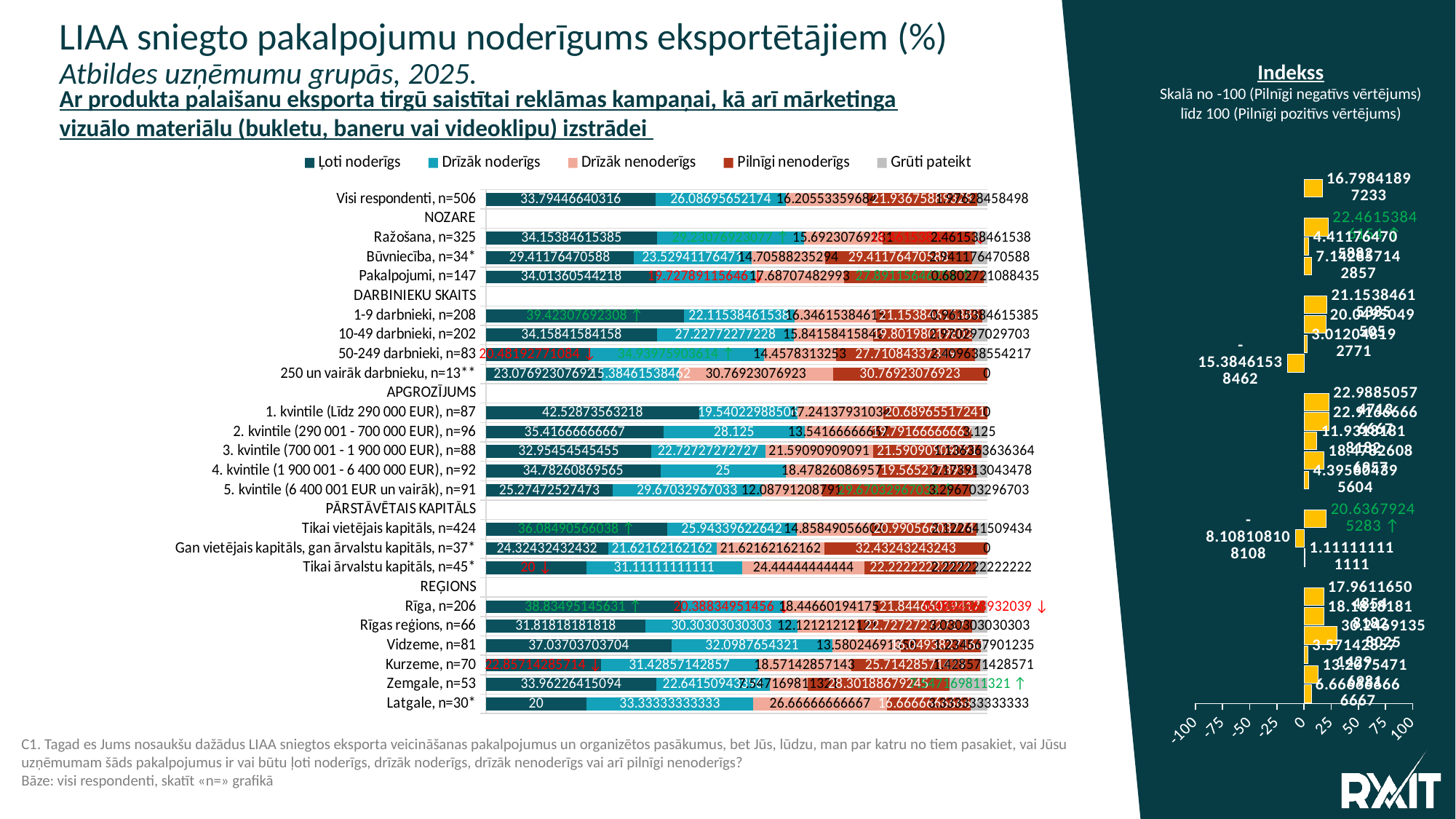
In the main chart, what is the 'Drīzāk noderīgs' value for 'Vidzeme, n=81'? 32.0987654321 In the main chart, which category has the highest 'Ļoti noderīgs' value? 1. kvintile (Līdz 290 000 EUR), n=87 How many series does the legend of the main chart list? 5 In the main chart, what is the 'Ļoti noderīgs' value for 'Tikai ārvalstu kapitāls, n=45*'? 20 In the main chart, what is the 'Ļoti noderīgs' value for '1. kvintile (Līdz 290 000 EUR), n=87'? 42.52873563218 In the main chart, what is the 'Pilnīgi nenoderīgs' value for 'Gan vietējais kapitāls, gan ārvalstu kapitāls, n=37*'? 32.43243243243 In the 'Indekss' chart on the right, which category has the lowest index value? 250 un vairāk darbnieku, n=13** In the 'Indekss' chart on the right, what is the index value for 'Visi respondenti, n=506'? 16.79841897233 What kind of chart is the main chart on the left of the slide? Stacked bar chart In the main chart, which has the larger 'Ļoti noderīgs' value: 'Rīga, n=206' or 'Rīgas reģions, n=66'? Rīga, n=206 In the main chart, what is the 'Drīzāk noderīgs' value for 'Latgale, n=30*'? 33.33333333333 In the 'Indekss' chart on the right, what is the index value for 'Gan vietējais kapitāls, gan ārvalstu kapitāls, n=37*'? -8.108108108108